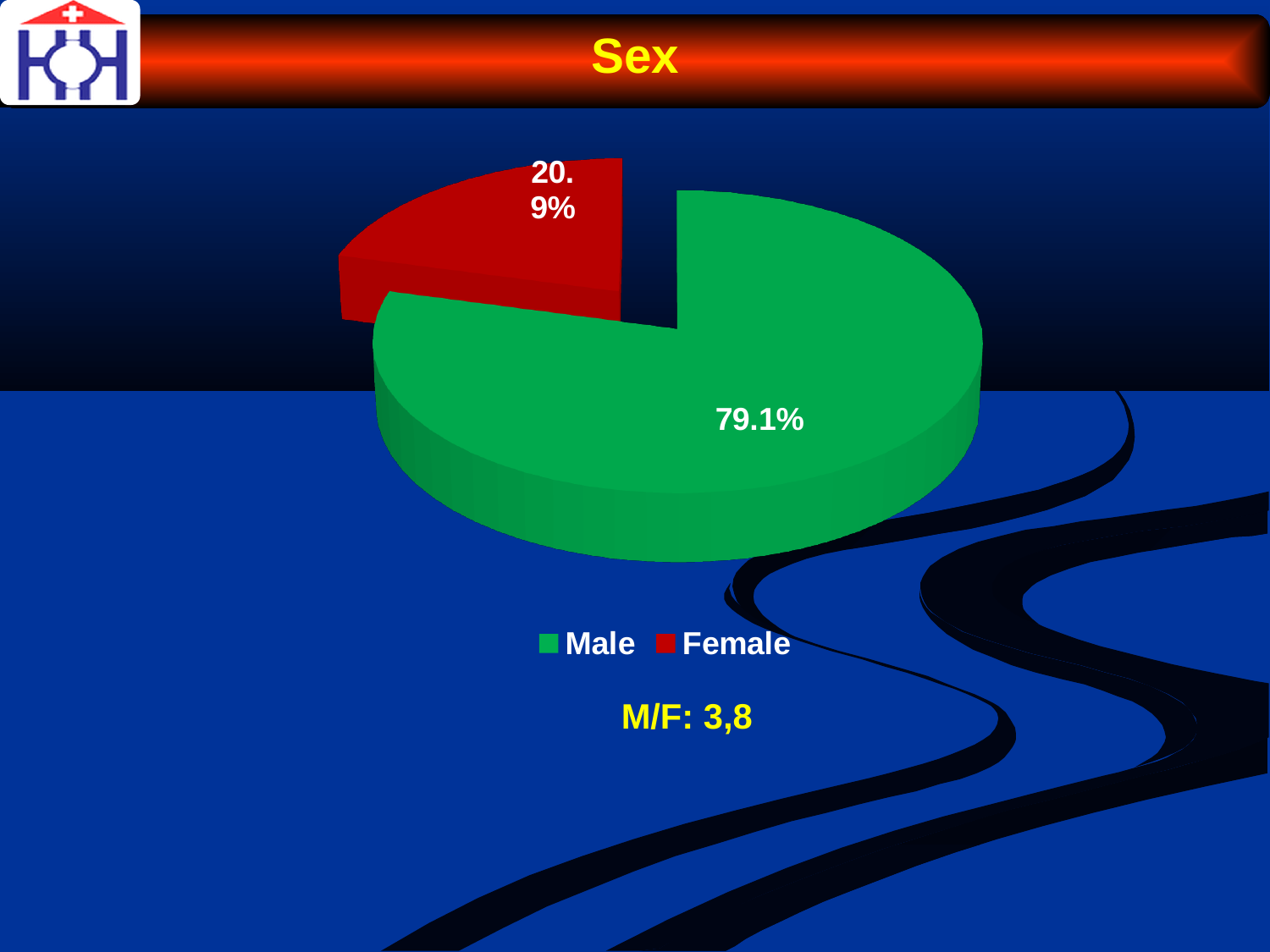
What percentage of the pie is Female? 20.9% Which is larger, the Male share or the Female share? Male What colour is the Female slice? red Which category has the smallest share of the pie? Female What M/F ratio is stated below the chart? 3,8 How many slices does the pie chart have? 2 What is the difference in percentage points between the Male and Female shares? 58.2 What is the title of the chart? Sex What kind of chart is shown on the slide? pie chart What percentage of the pie is Male? 79.1% Which category has the largest share of the pie? Male How many entries does the legend list? 2